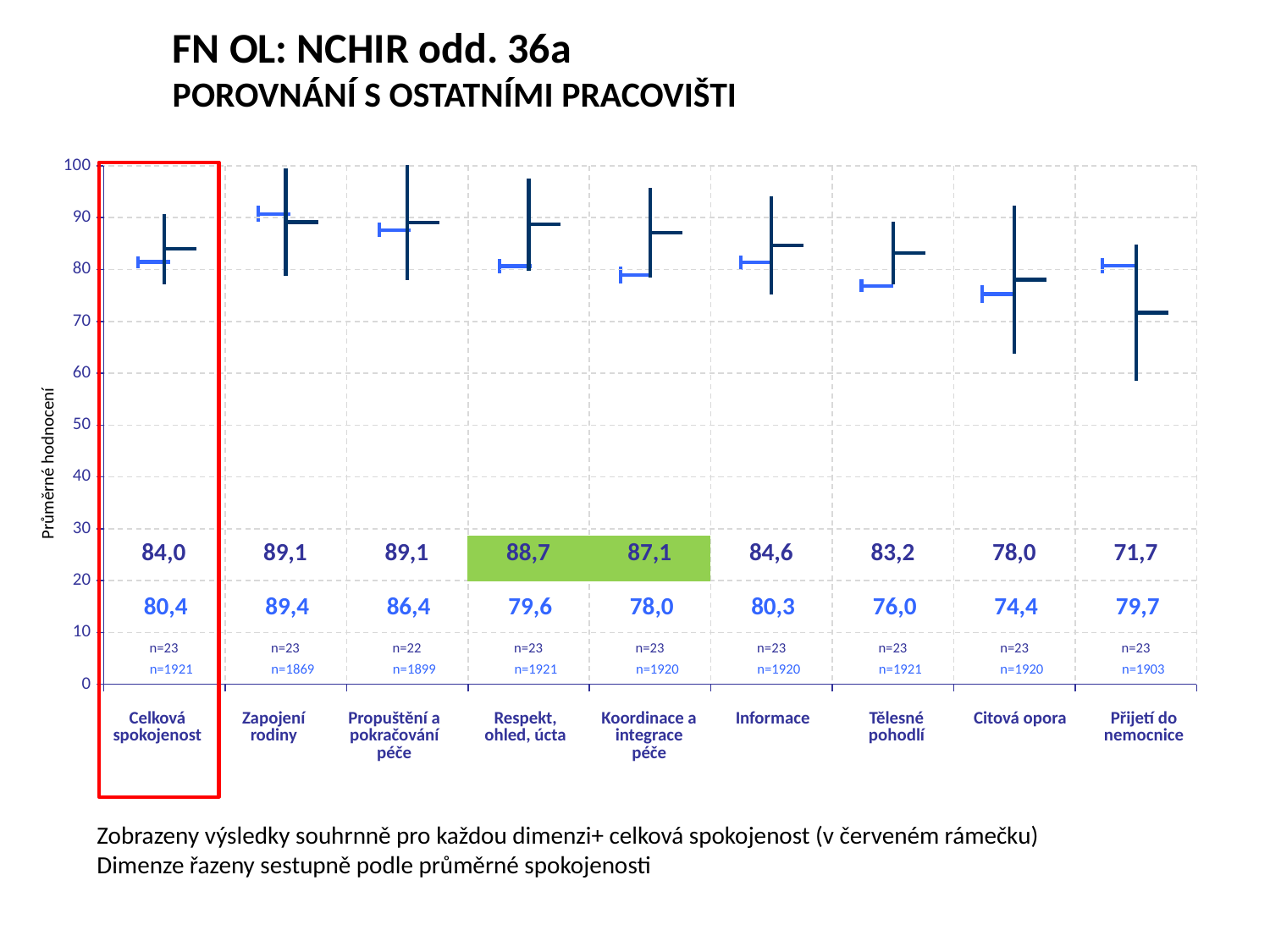
For Přijetí do nemocnice, what is the difference between the light blue value (79,7) and the dark blue value (71,7)? 8,0 Which category has the highest light blue (lower row) value? Zapojení rodiny Which category has the lowest dark blue (upper row) value? Přijetí do nemocnice How many categories are shown on the x axis? 9 For Zapojení rodiny, which is larger: the dark blue value or the light blue value? the light blue value (89,4) What is the smaller n value shown under Propuštění a pokračování péče? n=22 For Celková spokojenost, what is the difference between the dark blue value (84,0) and the light blue value (80,4)? 3,6 What is the light blue (lower row) value for Tělesné pohodlí? 76,0 Which category is highlighted with a red frame? Celková spokojenost Is the dark blue value for Přijetí do nemocnice greater or less than 80? less Which category has the lowest light blue (lower row) value? Citová opora What is the dark blue (upper row) value for Informace? 84,6